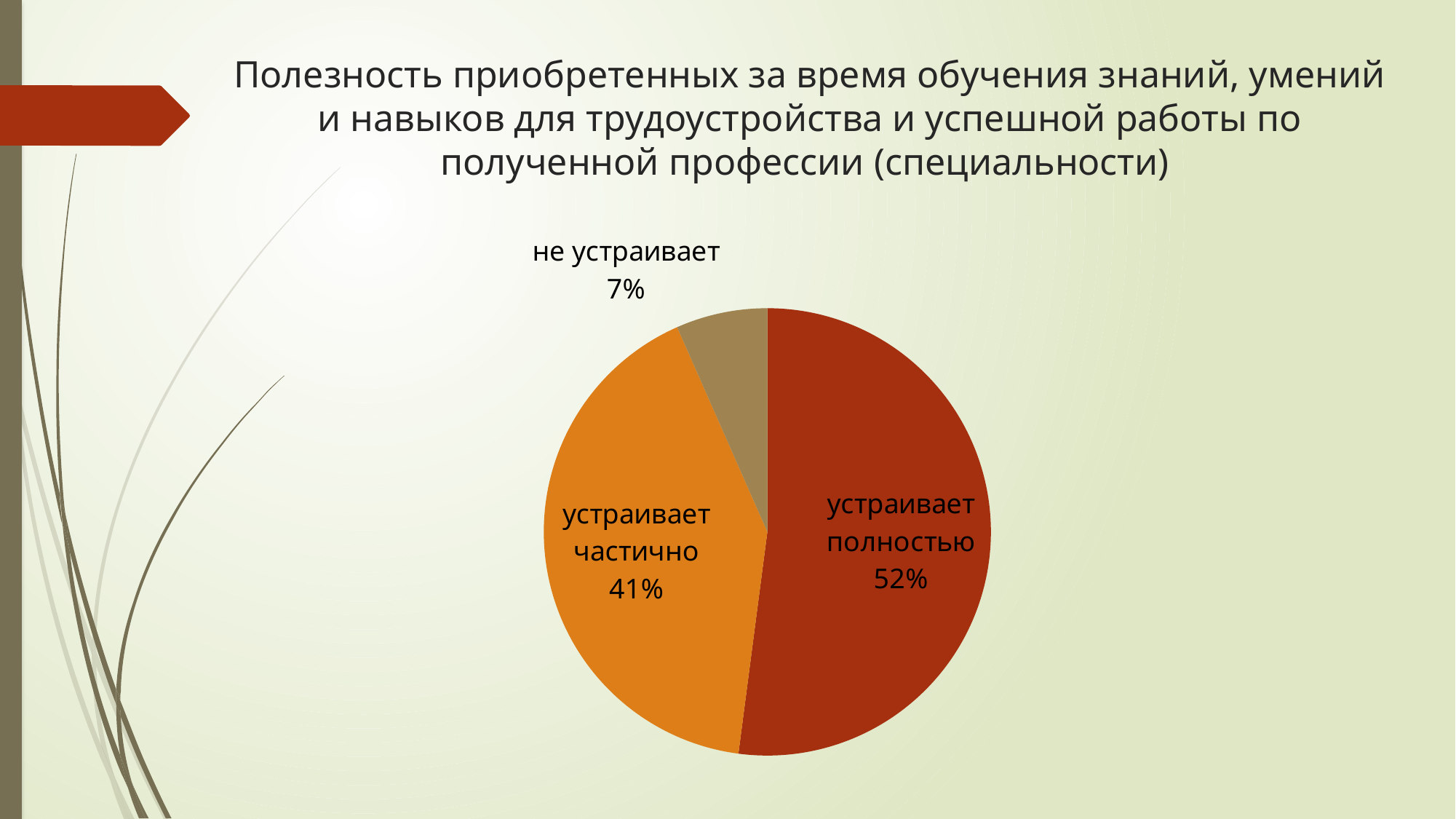
Which slice of the pie is the largest? устраивает полностью What share of the pie is labelled "устраивает полностью"? 52% Which is larger: the share for "устраивает частично" or the share for "не устраивает"? устраивает частично Which slice of the pie is the smallest? не устраивает What colour is the "устраивает полностью" slice? dark red What share of the pie is labelled "не устраивает"? 7% What is the difference in percentage points between "устраивает полностью" and "устраивает частично"? 11 What type of chart is shown on the slide? pie chart What colour is the "не устраивает" slice? brown What share of the pie is labelled "устраивает частично"? 41% How many slices does the pie chart have? 3 What is the difference in percentage points between "устраивает частично" and "не устраивает"? 34